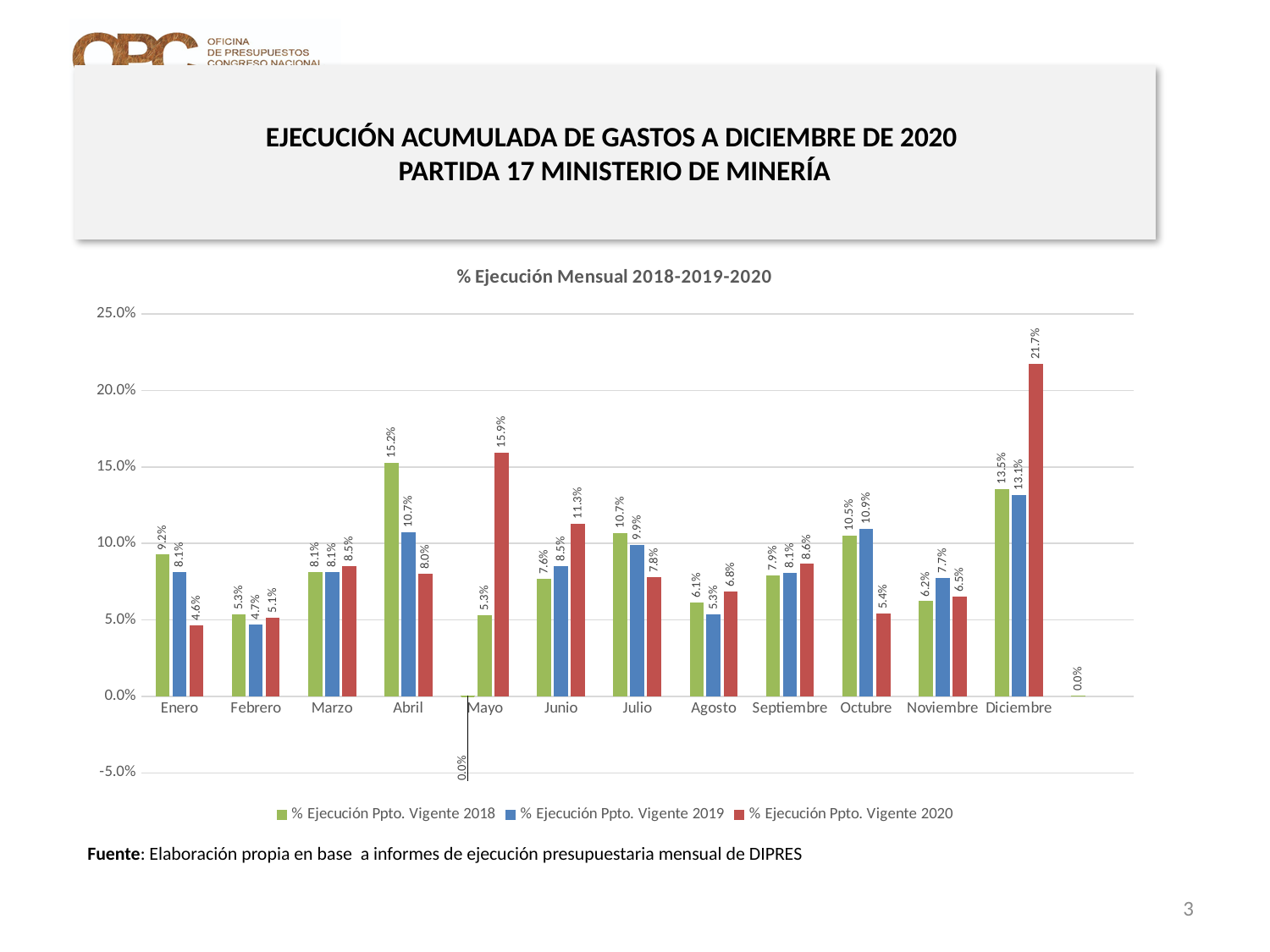
How many series does the legend list? 3 Which month has the highest value in the % Ejecución Ppto. Vigente 2018 series? Abril What is the difference between the 2018 and 2019 values for Abril? 4.5 percentage points Which month has the highest value in the % Ejecución Ppto. Vigente 2020 series? Diciembre Is the value for Junio in the 2020 series greater or less than 10.0%? greater What is the value for Abril in the % Ejecución Ppto. Vigente 2018 series? 15.2% What is the value for Diciembre in the % Ejecución Ppto. Vigente 2020 series? 21.7% What kind of chart is shown on the slide? Bar chart What is the value for Octubre in the % Ejecución Ppto. Vigente 2019 series? 10.9% What is the difference between the 2020 and 2018 values for Diciembre? 8.2 percentage points For Mayo, which series has the larger value: % Ejecución Ppto. Vigente 2019 or % Ejecución Ppto. Vigente 2020? % Ejecución Ppto. Vigente 2020 Which month has the lowest value in the % Ejecución Ppto. Vigente 2020 series? Enero